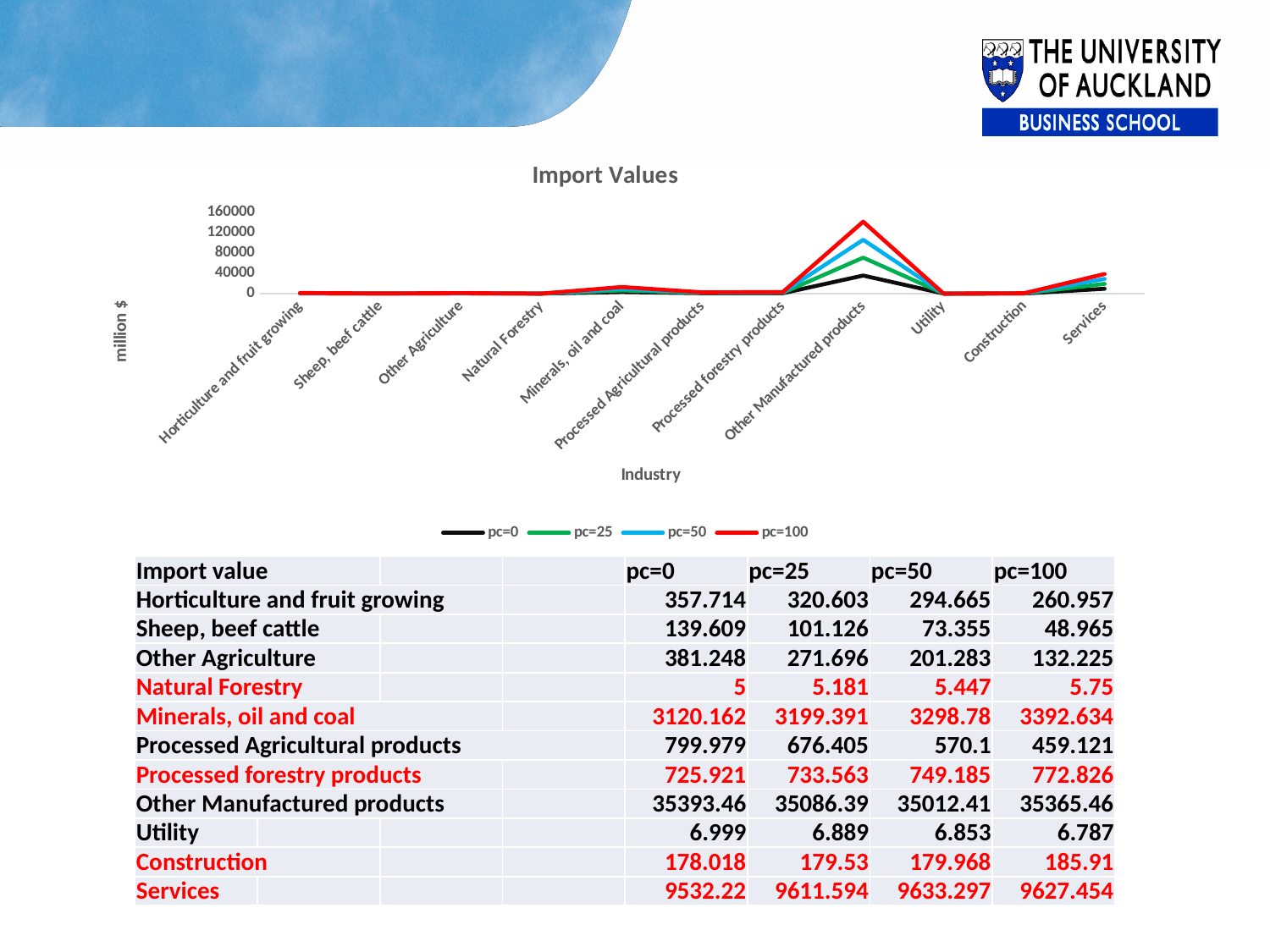
Which industry has the highest value for the pc=100 series in the chart? Other Manufactured products How many series does the chart's legend list? 4 At Other Manufactured products, which is larger: the pc=50 value or the pc=25 value? pc=25 What kind of chart is shown on the slide? line chart At Other Manufactured products, which series has the lowest value in the chart? pc=50 What is the title of the chart? Import Values At Other Manufactured products, which series has the highest value in the chart? pc=0 Is the pc=0 value for Horticulture and fruit growing greater or less than 40000? less Is the pc=100 value for Other Manufactured products greater or less than 80000? less How many industry categories are plotted along the x axis of the chart? 11 What is the label on the chart's y axis? million $ Which series is drawn in red in the chart? pc=100